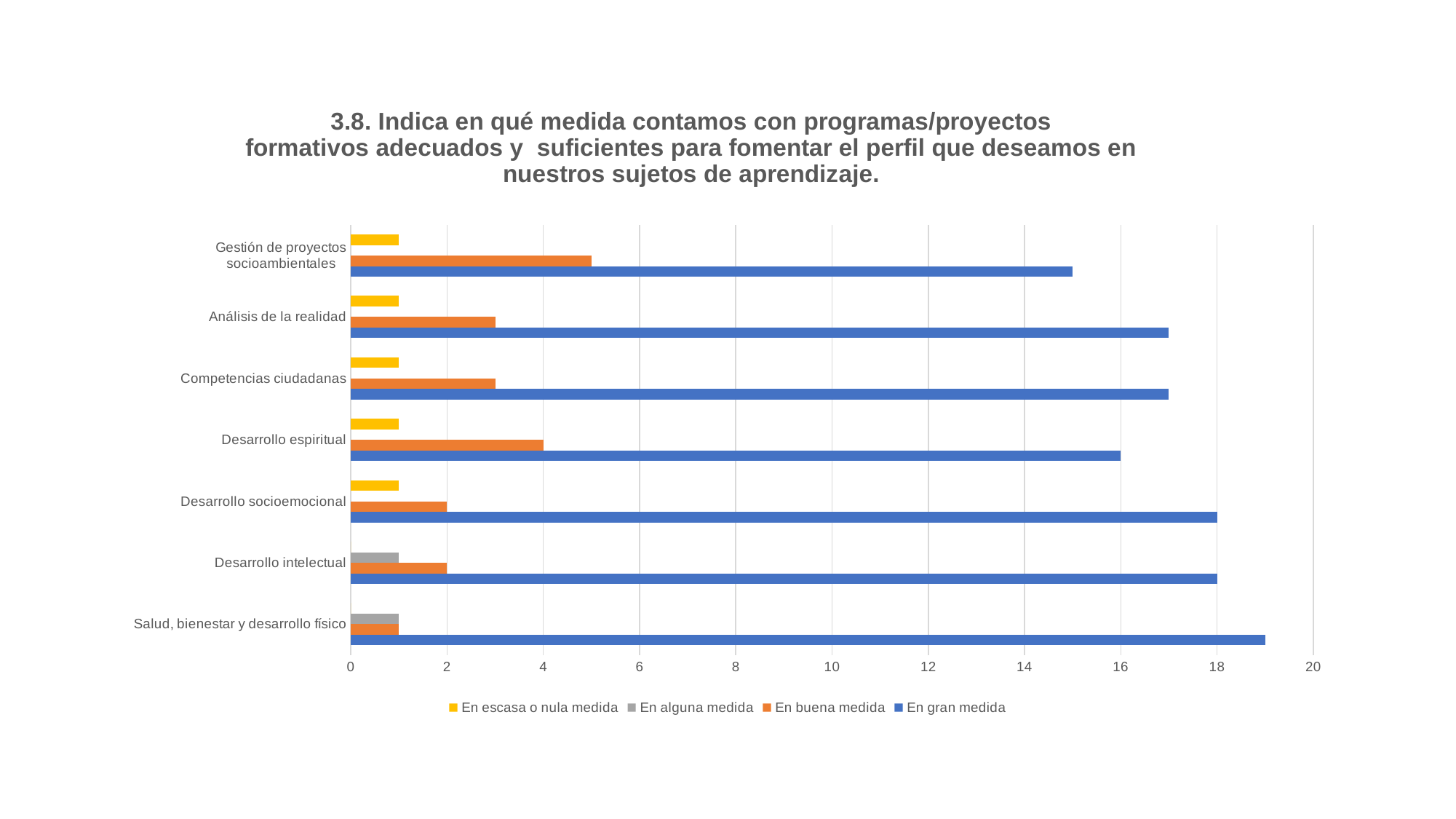
What is the value of 'En gran medida' for Desarrollo socioemocional? 18 What type of chart is shown on the slide? Bar chart What is the value of 'En buena medida' for Desarrollo intelectual? 2 What is the difference between the 'En gran medida' values for Desarrollo socioemocional and Desarrollo espiritual? 2 What is the value of 'En buena medida' for Desarrollo espiritual? 4 Which category has the highest value for 'En gran medida'? Salud, bienestar y desarrollo físico How many series does the chart legend list? 4 Which category has the lowest value for 'En gran medida'? Gestión de proyectos socioambientales Which series is shown in blue in the legend? En gran medida Is the 'En gran medida' value for Salud, bienestar y desarrollo físico greater or less than 18? greater What is the value of 'En gran medida' for Desarrollo espiritual? 16 How many categories are plotted on the vertical axis of the chart? 7